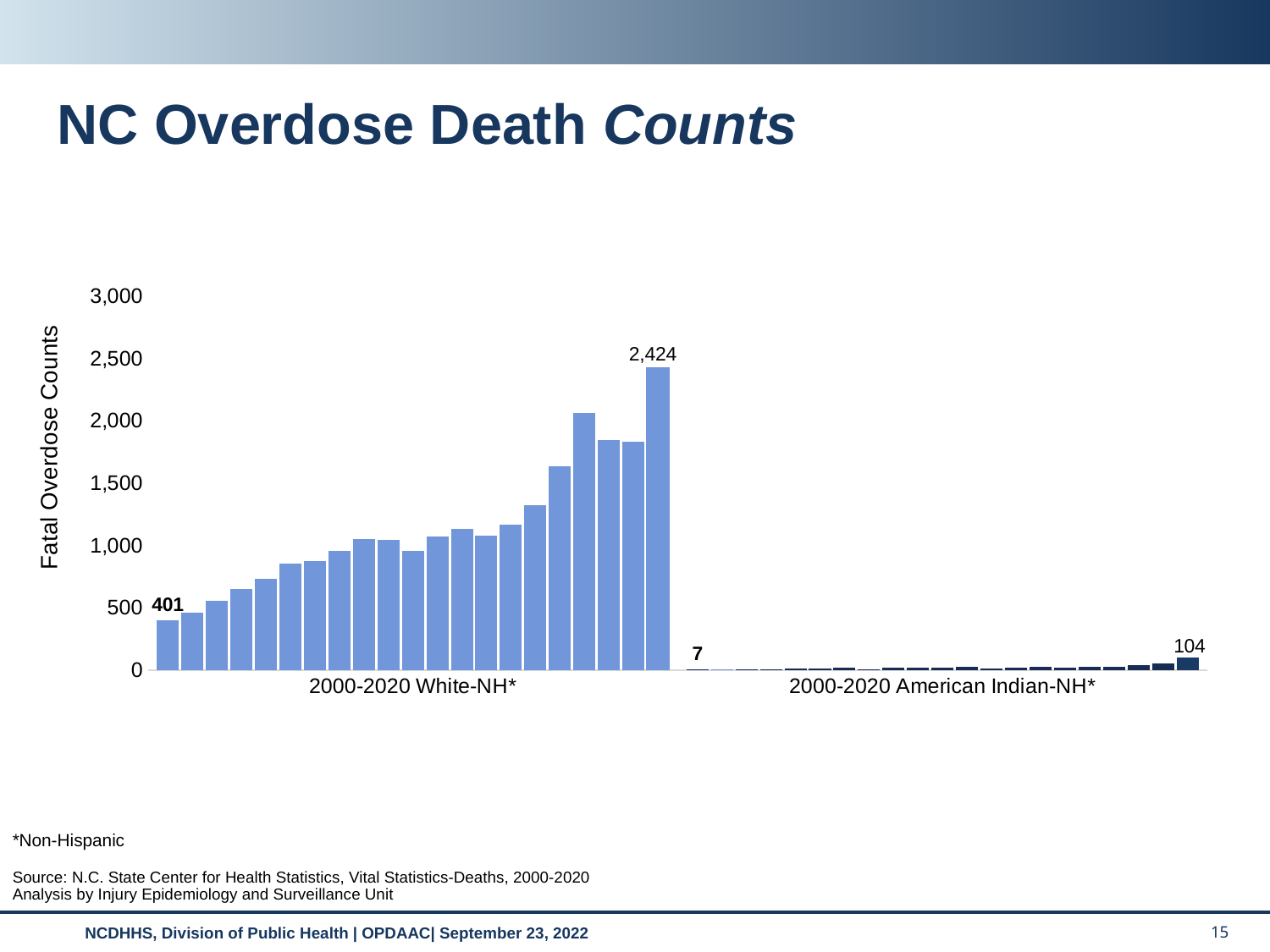
Do the fatal overdose counts for White-NH generally rise or fall from 2000 to 2020? Rise What is the fatal overdose count for American Indian-NH in 2000, the first bar of the 2000-2020 American Indian-NH* group? 7 What is the fatal overdose count for White-NH in 2020, the last bar of the 2000-2020 White-NH* group? 2,424 What is the fatal overdose count for American Indian-NH in 2020, the last bar of the 2000-2020 American Indian-NH* group? 104 What is the fatal overdose count for White-NH in 2000, the first bar of the 2000-2020 White-NH* group? 401 What is the title of the vertical axis? Fatal Overdose Counts By how much did the White-NH fatal overdose count increase from 2000 (401) to 2020 (2,424)? 2,023 By how much did the American Indian-NH fatal overdose count increase from 2000 (7) to 2020 (104)? 97 Which group had the higher fatal overdose count in 2020, White-NH or American Indian-NH? White-NH What kind of chart is shown on the slide? Bar chart Is the 2020 White-NH fatal overdose count greater or less than 2,000? greater Which bar on the chart is the highest? 2020 White-NH